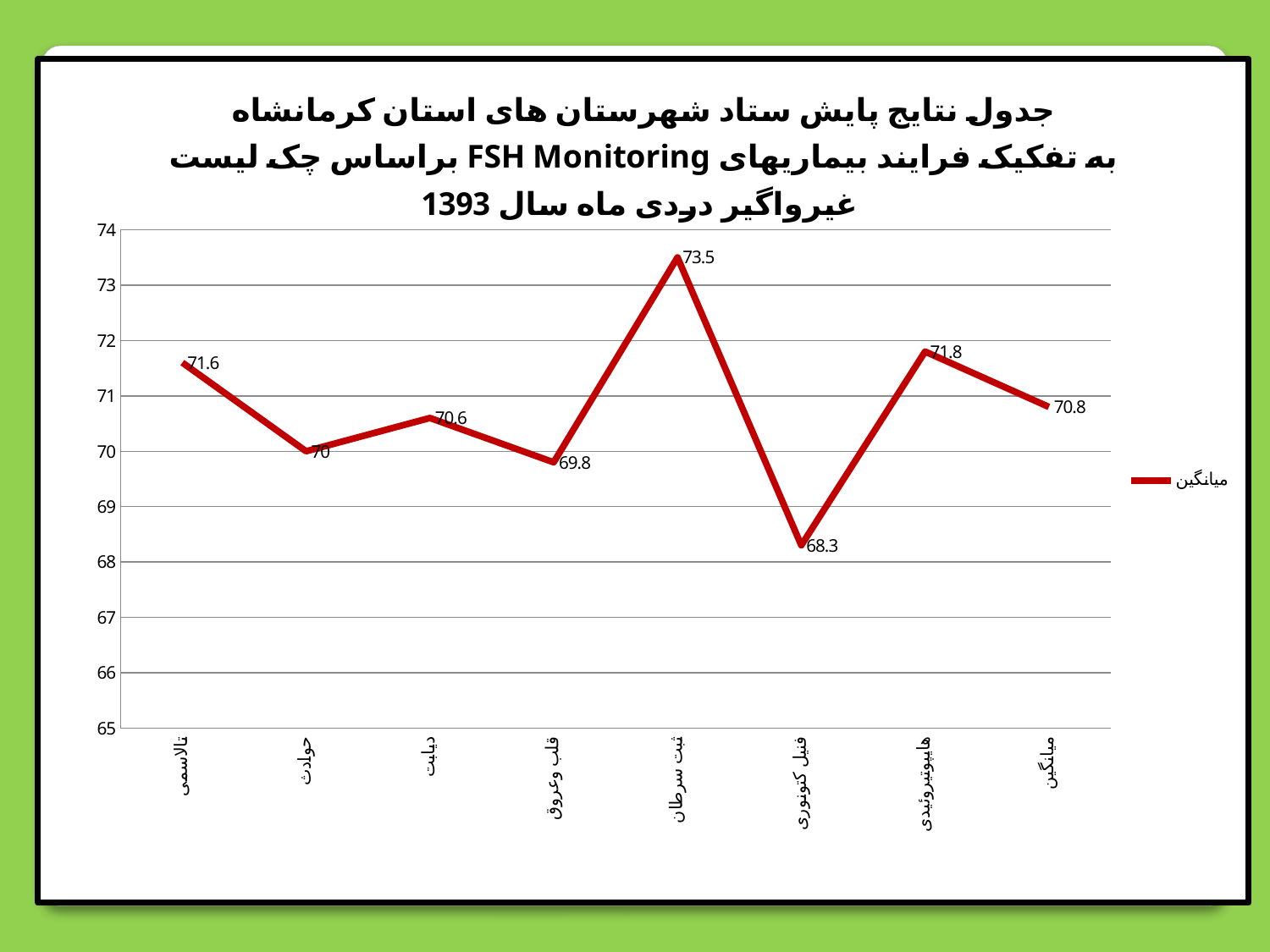
What is the value for فنیل کتونوری? 68.3 What is the difference between the values for ثبت سرطان and فنیل کتونوری? 5.2 What is the value for میانگین? 70.8 Which category has the highest value? ثبت سرطان How many series does the legend list? 1 How many categories are plotted on the x axis? 8 Which category has the lowest value? فنیل کتونوری What kind of chart is shown on the slide? line chart Which is larger, the value for هایپوتیروئیدی or the value for دیابت? هایپوتیروئیدی What is the value for تالاسمی? 71.6 What is the value for ثبت سرطان? 73.5 Is the value for قلب وعروق greater or less than 70? less